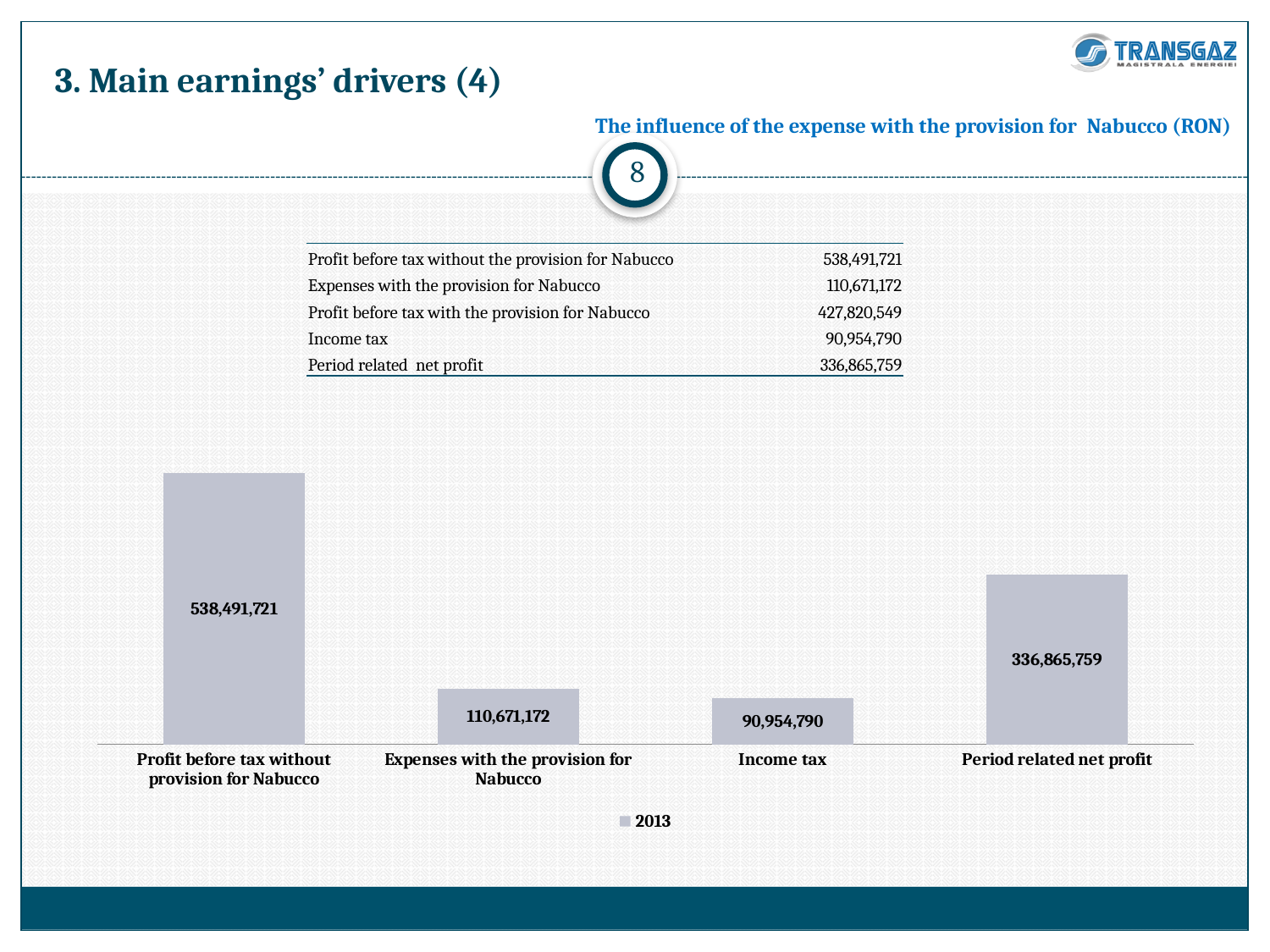
Which category has the lowest value? Income tax How many series does the legend list? 1 Which category has the highest value? Profit before tax without provision for Nabucco How many categories are shown on the chart? 4 Which is larger, Expenses with the provision for Nabucco or Income tax? Expenses with the provision for Nabucco What is the difference between Expenses with the provision for Nabucco and Income tax? 19,716,382 What is the value for Income tax? 90,954,790 What is the difference between Profit before tax without provision for Nabucco and Period related net profit? 201,625,962 What is the value for Expenses with the provision for Nabucco? 110,671,172 What kind of chart is shown on the slide? Bar chart What is the value for Profit before tax without provision for Nabucco? 538,491,721 What is the value for Period related net profit? 336,865,759